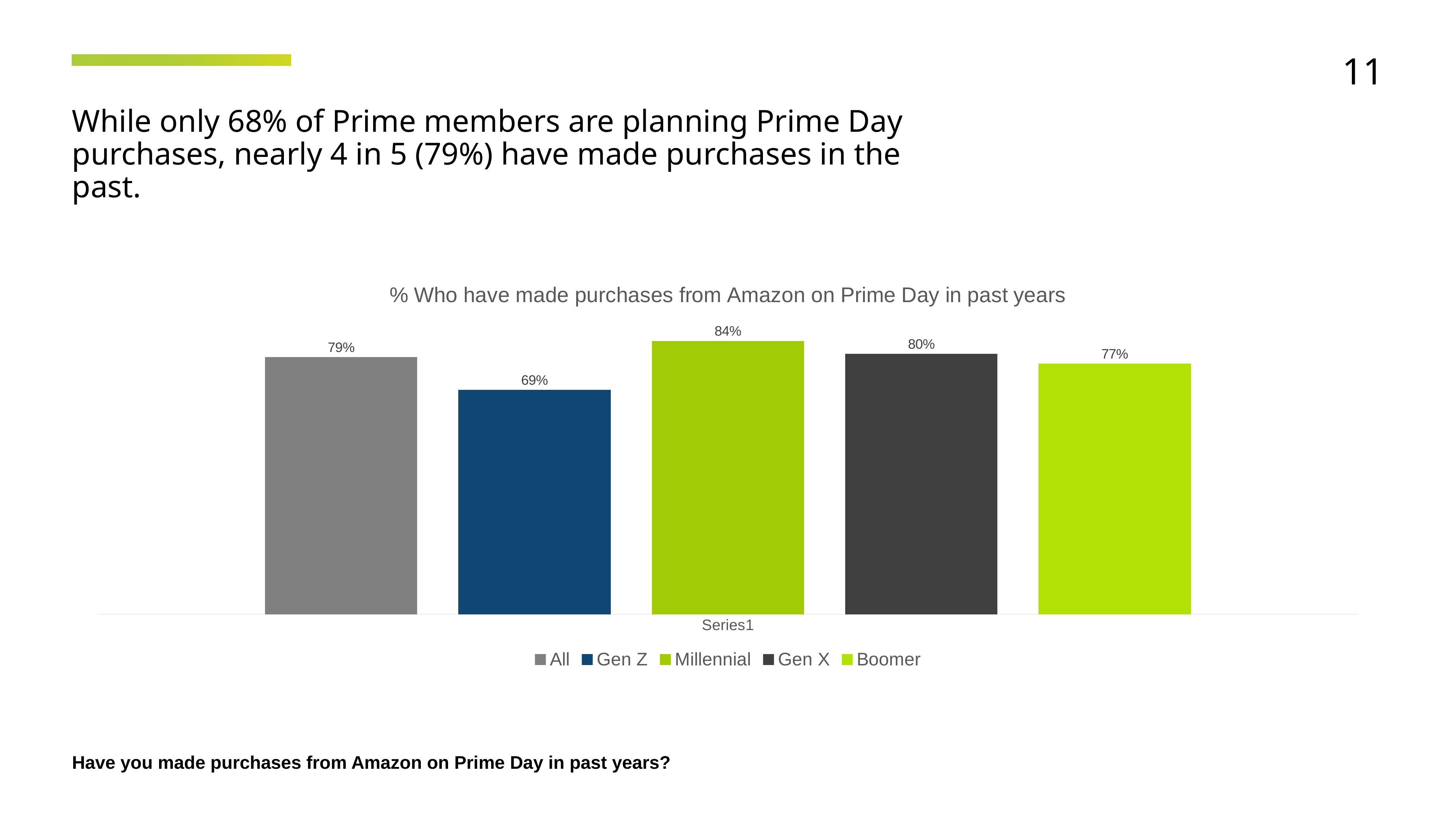
What is the value shown for Boomer in the chart? 77% How many entries does the legend list? 5 Which is larger, the value for Gen X or the value for Gen Z? Gen X How many bars are plotted in the chart? 5 What percentage of Gen Z respondents have made purchases from Amazon on Prime Day in past years? 69% What is the difference between the Gen X value and the Boomer value? 3% What is the difference between the Millennial value and the Gen Z value? 15% What is the value shown for All in the chart? 79% What type of chart is shown on the slide? Bar chart Which group has the highest percentage of past Prime Day purchasers? Millennial Which group has the lowest percentage of past Prime Day purchasers? Gen Z What is the value shown for Millennial in the chart? 84%